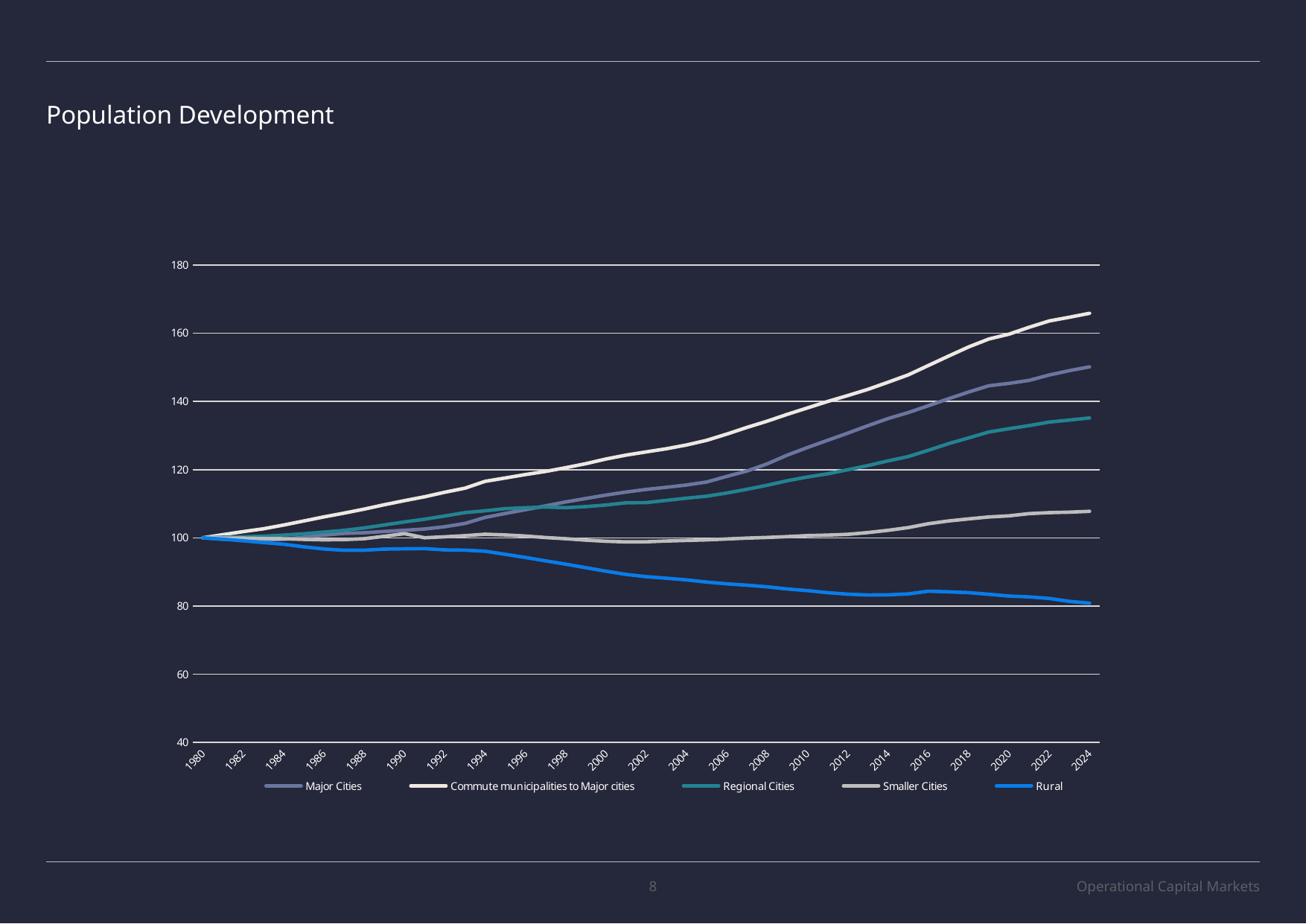
What value do all series start at in 1980? 100 What kind of chart is shown on the slide? line chart Is the value for Regional Cities in 2024 greater or less than 140? less How many series does the legend list? 5 What is the title of the chart? Population Development Which series has the lowest value in 2024? Rural How many year labels are shown on the x axis? 23 Does the Rural series rise or fall from 1980 to 2024? fall Does the Commute municipalities to Major cities series rise or fall from 1980 to 2024? rise Is the value for Commute municipalities to Major cities in 2024 greater or less than 160? greater In 2024, which is higher: Major Cities or Regional Cities? Major Cities Which series has the highest value in 2024? Commute municipalities to Major cities